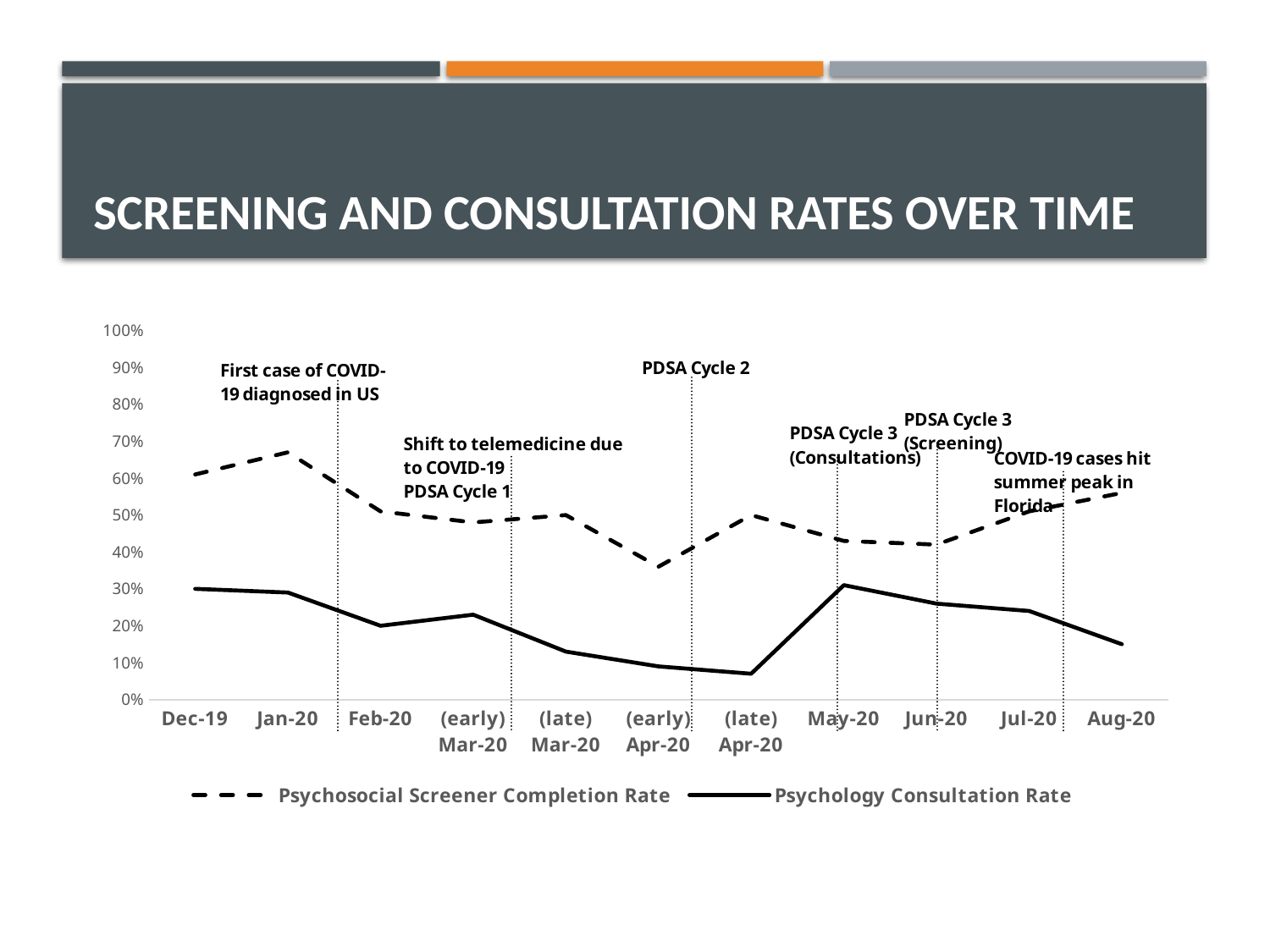
Is the Psychosocial Screener Completion Rate for Jan-20 greater or less than 60%? greater In Dec-19, which is larger: the Psychosocial Screener Completion Rate or the Psychology Consultation Rate? Psychosocial Screener Completion Rate Is the Psychosocial Screener Completion Rate for (early) Apr-20 greater or less than 40%? less In which month is the Psychosocial Screener Completion Rate lowest? (early) Apr-20 Is the Psychology Consultation Rate for Aug-20 greater or less than 20%? less How many time points are plotted along the x axis? 11 In which month is the Psychosocial Screener Completion Rate highest? Jan-20 Does the Psychology Consultation Rate rise or fall from Dec-19 to (late) Apr-20? Fall How many series does the legend list? 2 What type of chart is shown on the slide? Line chart Which series is drawn with a dashed line? Psychosocial Screener Completion Rate